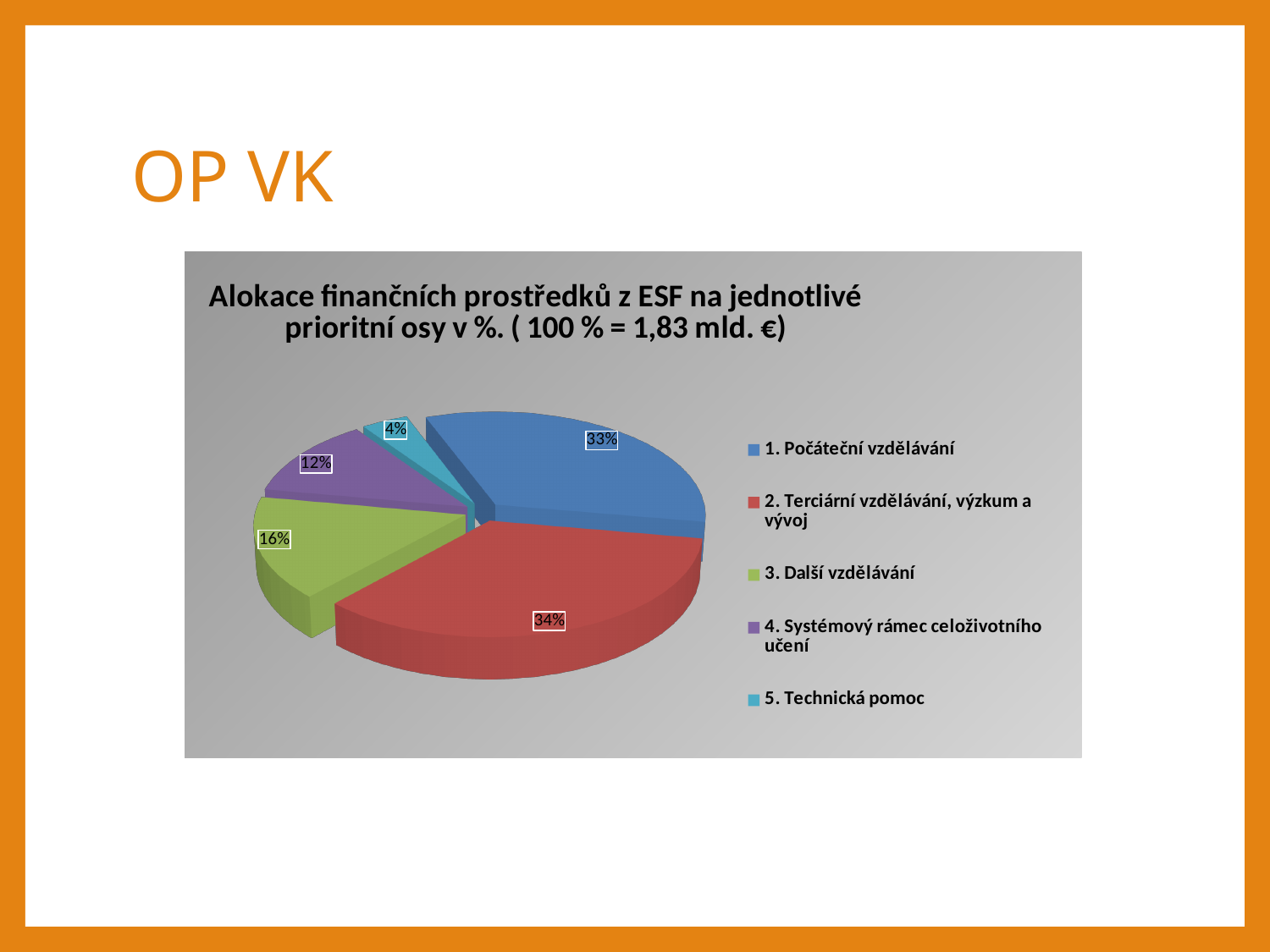
Which category has the smallest share of the pie? 5. Technická pomoc What share of the pie does "3. Další vzdělávání" have? 16% Which category has the largest share of the pie? 2. Terciární vzdělávání, výzkum a vývoj What kind of chart is shown on the slide? pie chart What share of the pie does "2. Terciární vzdělávání, výzkum a vývoj" have? 34% What share of the pie does "4. Systémový rámec celoživotního učení" have? 12% What share of the pie does "1. Počáteční vzdělávání" have? 33% Which is larger: the share for "1. Počáteční vzdělávání" or the share for "3. Další vzdělávání"? 1. Počáteční vzdělávání What is the title of the chart? Alokace finančních prostředků z ESF na jednotlivé prioritní osy v %. ( 100 % = 1,83 mld. €) How many slices does the pie chart have? 5 What is the difference in percentage points between "3. Další vzdělávání" and "4. Systémový rámec celoživotního učení"? 4 What share of the pie does "5. Technická pomoc" have? 4%